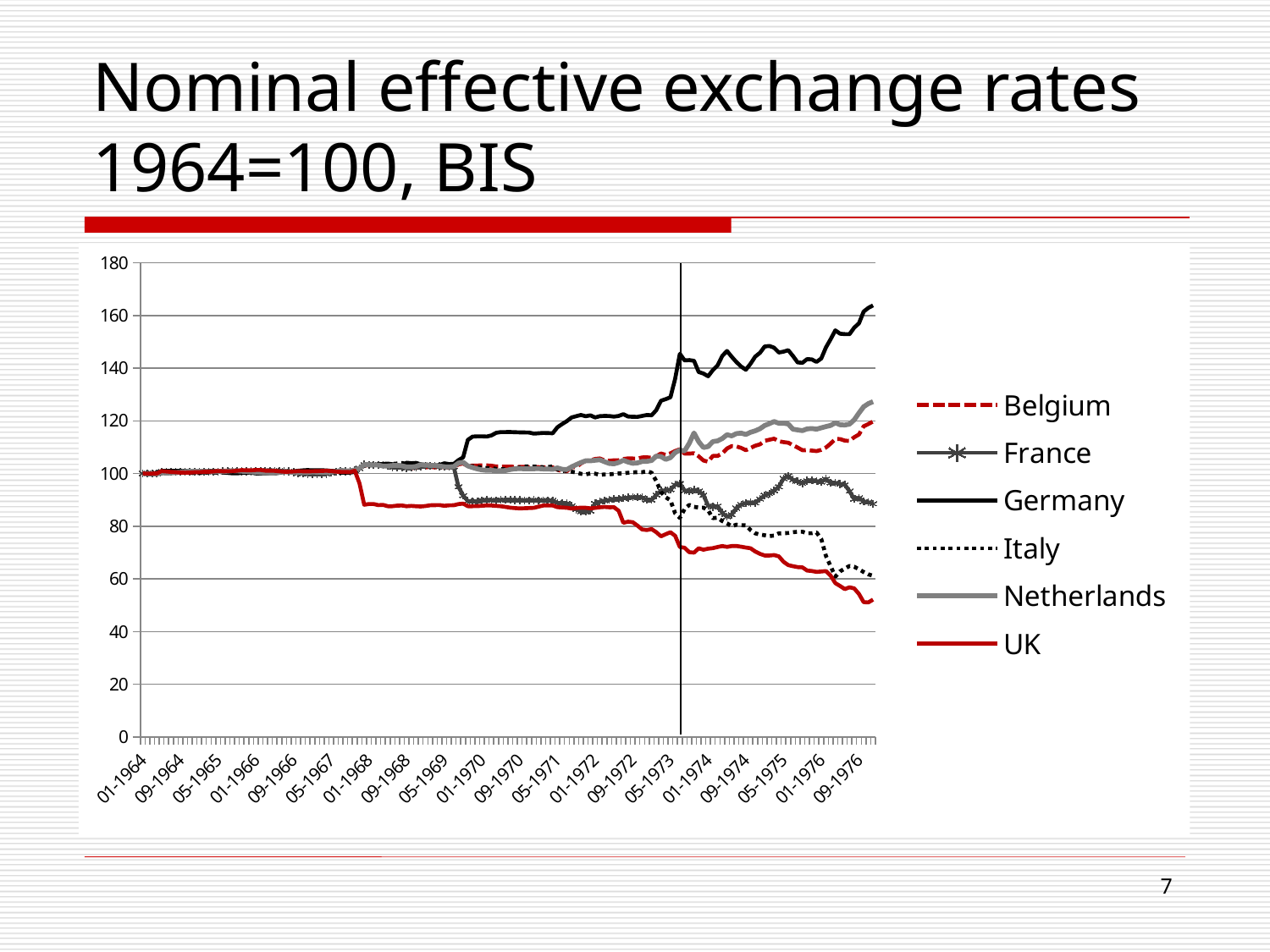
Which country has the highest nominal effective exchange rate at the end of the period (09-1976)? Germany What kind of chart is shown on the slide? line chart Is the value for the UK at 09-1976 greater or less than 60? less Is the value for Germany at 09-1976 greater or less than 140? greater How many series does the legend list? 6 Does the Germany series rise or fall from 01-1964 to 09-1976? rise Which country has the lowest nominal effective exchange rate at the end of the period (09-1976)? UK At 09-1976, which is larger: the value for Belgium or the value for Italy? Belgium Which series is drawn with star markers in the legend? France Does the UK series rise or fall from 01-1964 to 09-1976? fall Is the value for Italy at 09-1976 greater or less than 80? less